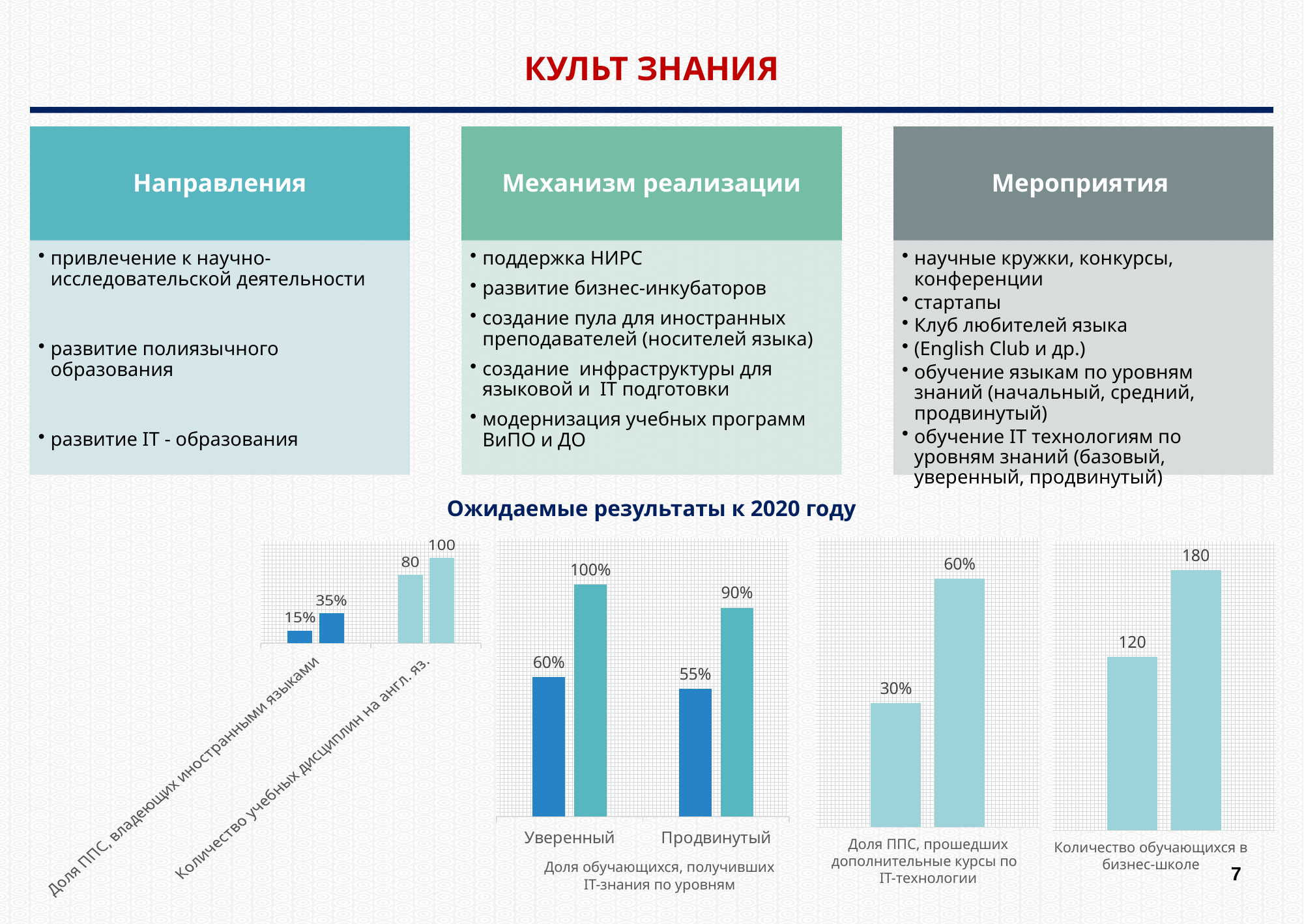
In the chart 'Доля обучающихся, получивших IT-знания по уровням', which category has the highest bar? Уверенный In the chart 'Доля ППС, прошедших дополнительные курсы по IT-технологии', what are the two values shown? 30% and 60% In the leftmost chart, what is the difference between the two bars for 'Количество учебных дисциплин на англ. яз.'? 20 In the chart 'Количество обучающихся в бизнес-школе', what is the difference between the two bars? 60 In the chart 'Доля обучающихся, получивших IT-знания по уровням', how many categories are shown on the x axis? 2 In the leftmost chart, what are the two values for 'Доля ППС, владеющих иностранными языками'? 15% and 35% In the chart 'Доля обучающихся, получивших IT-знания по уровням', what is the value of the shorter (dark blue) bar for 'Продвинутый'? 55% In the leftmost chart, what is the highest value for 'Количество учебных дисциплин на англ. яз.'? 100 In the chart 'Доля обучающихся, получивших IT-знания по уровням', what is the difference between the two bars for 'Уверенный'? 40% What type of chart is used for 'Доля обучающихся, получивших IT-знания по уровням'? Bar chart In the chart 'Доля обучающихся, получивших IT-знания по уровням', what is the value of the taller bar for 'Уверенный'? 100% In the chart 'Количество обучающихся в бизнес-школе', what is the value of the taller bar? 180